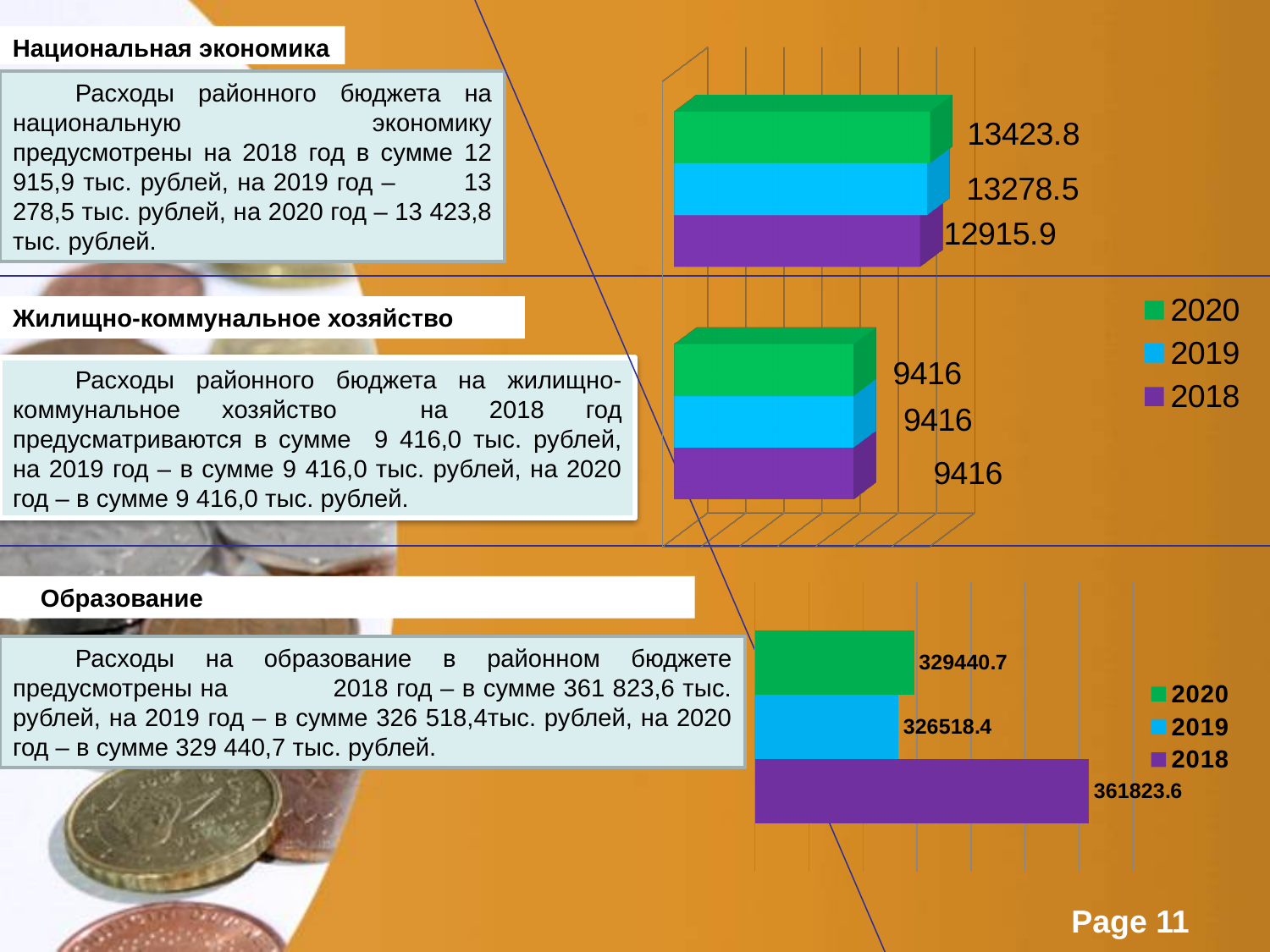
In the bottom chart, what is the value for 2019? 326518.4 In the bottom chart, what is the difference between the 2018 and 2020 values? 32382.9 In the top chart, what is the value of the 2019 bar in the lower group (housing and communal services)? 9416 In the top chart, what is the value of the 2018 bar in the upper group (national economy)? 12915.9 In the top chart, what is the value of the 2020 bar in the upper group (national economy)? 13423.8 In the bottom chart, is the value for 2020 larger or smaller than the value for 2018? Smaller In the top chart, what is the difference between the 2020 and 2018 values in the upper group (national economy)? 507.9 In the bottom chart, what is the value for 2018? 361823.6 In the top chart, how many series does the legend list? 3 In the bottom chart, which year has the lowest value? 2019 What type of chart is the bottom chart? Bar chart In the top chart, which year has the highest value in the upper group (national economy)? 2020